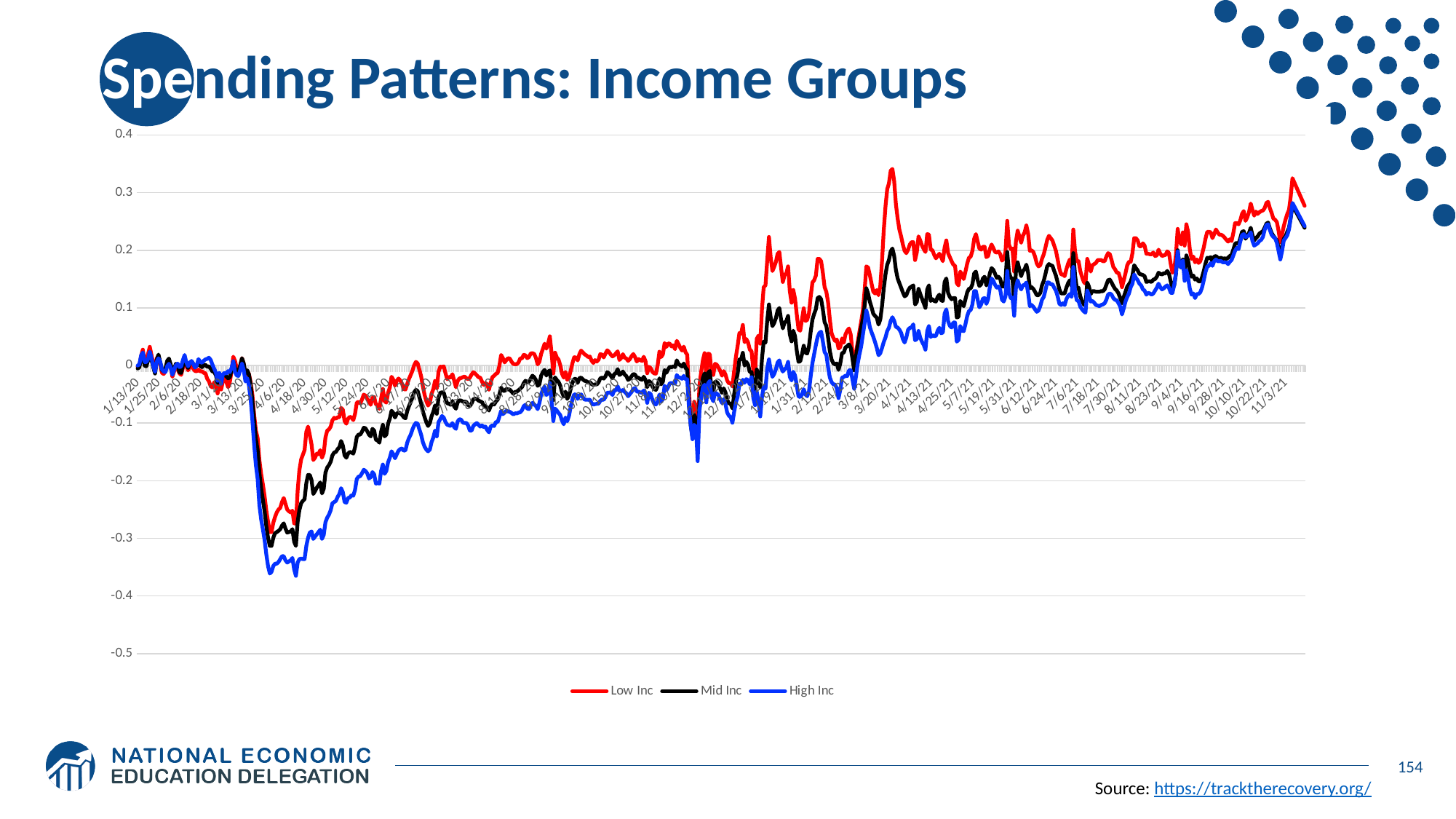
Is the lowest value of High Inc in spring 2020 greater or less than -0.3? less Is the lowest value of Low Inc in spring 2020 greater or less than -0.2? less Which colour is used for the High Inc series? blue What is the title of the chart on the slide? Spending Patterns: Income Groups How many series does the legend list? 3 From the spring 2020 trough to the end of 2021, do the series generally rise or fall? rise Is the Low Inc value at the last date (11/3/21) greater or less than 0.2? greater What kind of chart is shown on the slide? line chart Which series falls to the lowest value in spring 2020 (around 3/25/20)? High Inc At the last date on the chart (11/3/21), which is higher: Low Inc or High Inc? Low Inc Which series reaches the highest peak around 3/20/21? Low Inc